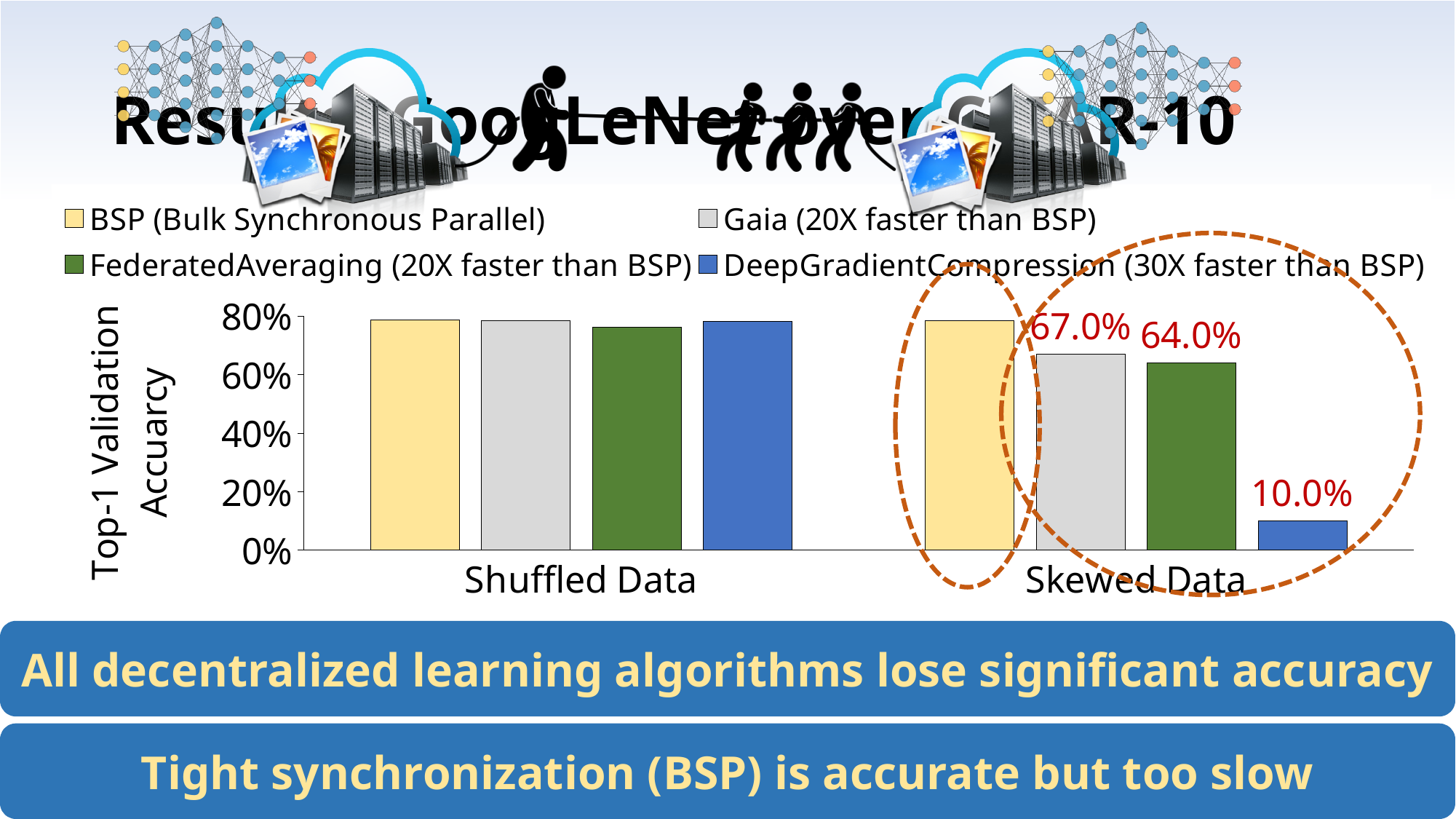
What is the difference between Gaia's and DeepGradientCompression's accuracy on Skewed Data? 57.0% What type of chart is shown on the slide? Bar chart Is the accuracy of BSP on Shuffled Data greater or less than 60%? greater How many series does the legend list? 4 Which algorithm has the highest accuracy on Skewed Data? BSP How many data categories are shown on the x axis? 2 What is the Top-1 validation accuracy of DeepGradientCompression on Skewed Data? 10.0% Which algorithm has the lowest accuracy on Skewed Data? DeepGradientCompression What is the Top-1 validation accuracy of Gaia on Skewed Data? 67.0% What is the Top-1 validation accuracy of FederatedAveraging on Skewed Data? 64.0% Is the accuracy of DeepGradientCompression on Skewed Data greater or less than 20%? less What is the difference between Gaia's and FederatedAveraging's accuracy on Skewed Data? 3.0%